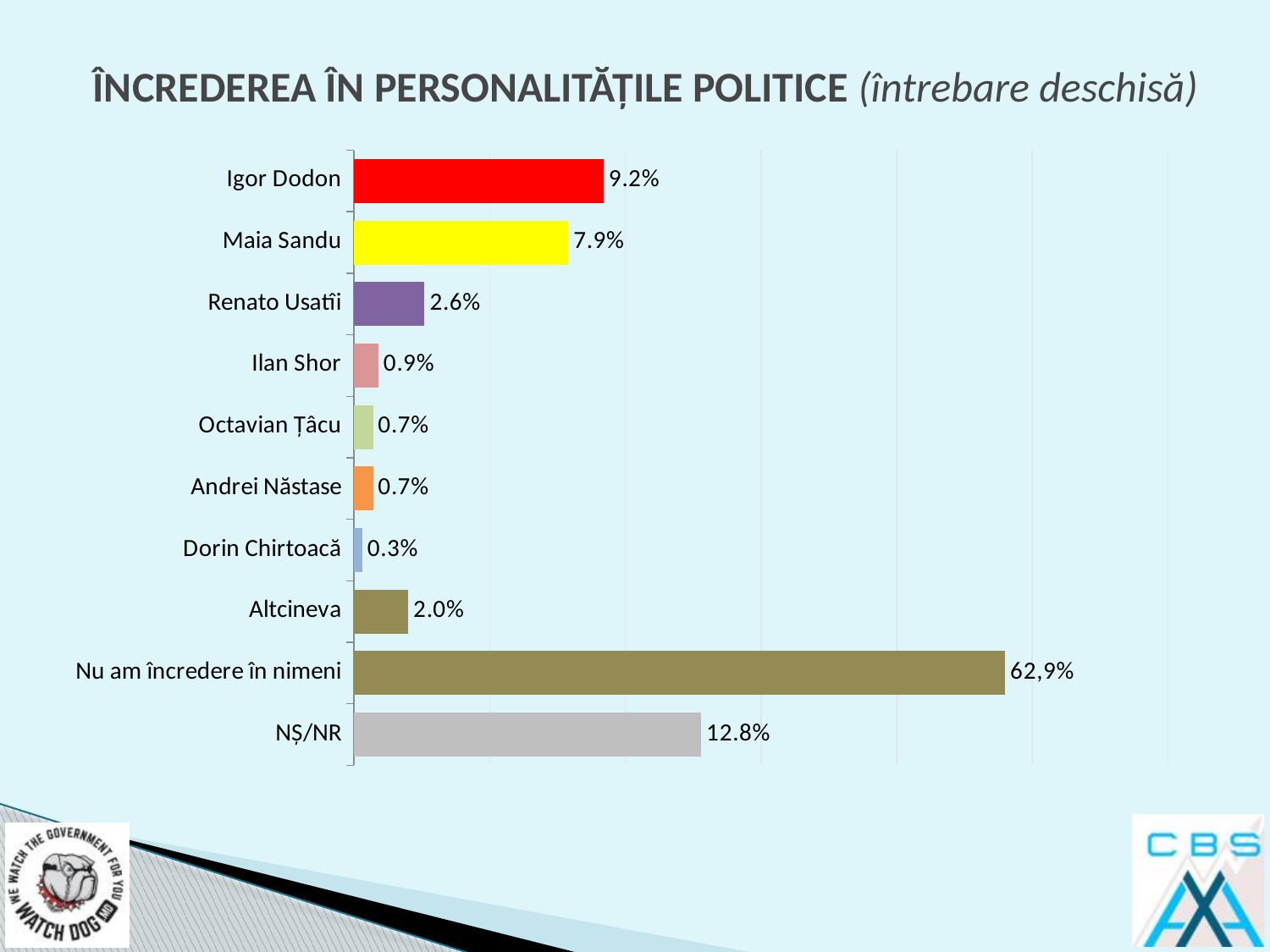
Which category has the highest value? Nu am încredere în nimeni How many categories are shown in the chart? 10 What kind of chart is shown on the slide? Bar chart What value is shown for NȘ/NR? 12.8% What colour is the bar for Maia Sandu? Yellow What value is shown for Igor Dodon? 9.2% What value is shown for Maia Sandu? 7.9% Which is larger, the value for Renato Usatîi or the value for Altcineva? Renato Usatîi What is the difference between the values for Igor Dodon and Maia Sandu? 1.3 percentage points Which category has the lowest value? Dorin Chirtoacă What value is shown for Renato Usatîi? 2.6% What value is shown for "Nu am încredere în nimeni"? 62,9%